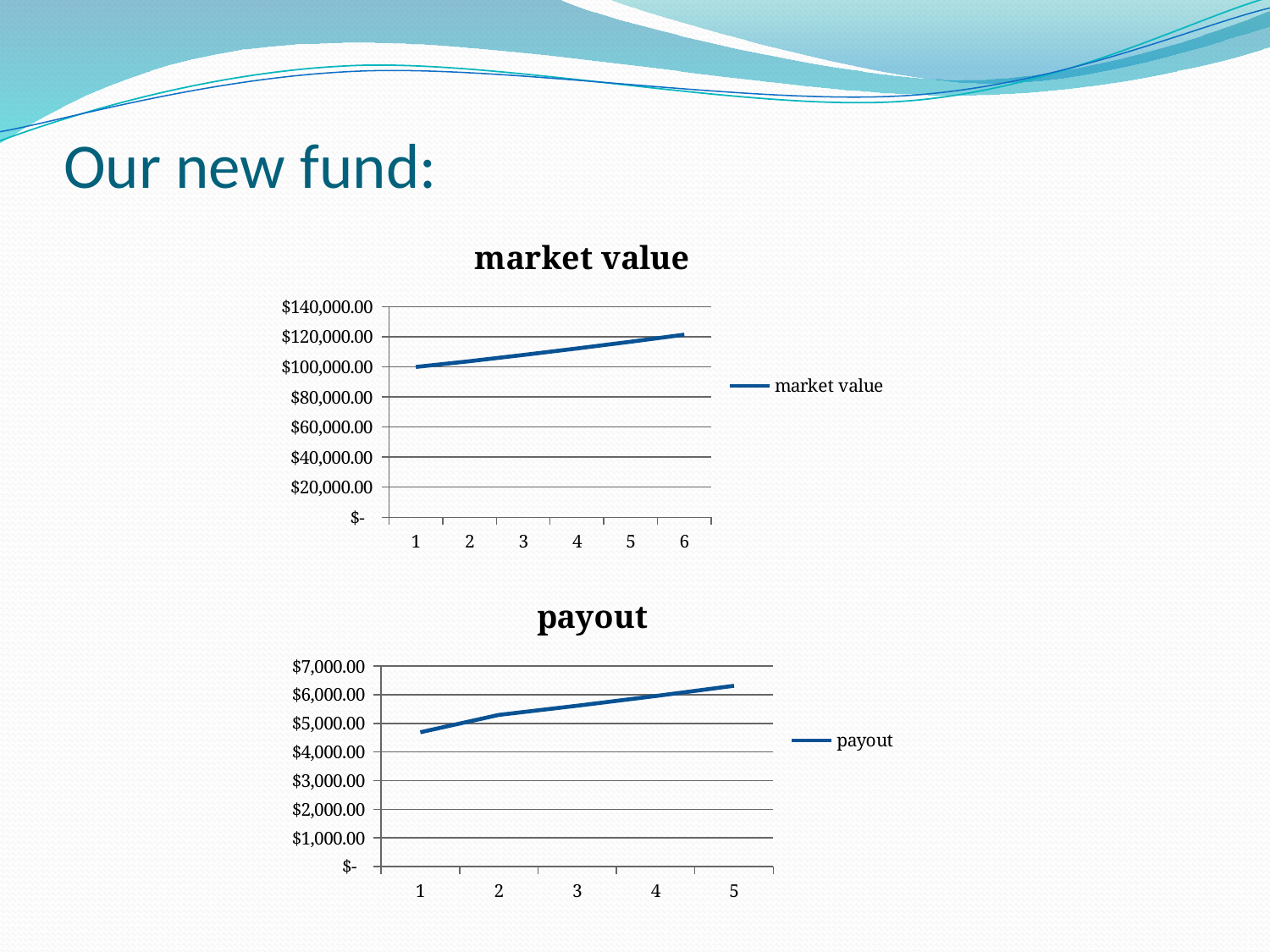
How many series does the legend of the "market value" chart list? 1 In the "market value" chart, how many points are plotted along the x axis? 6 What kind of chart is the "market value" chart? line chart In the "market value" chart, is the value at point 6 greater or less than $100,000.00? greater In the "payout" chart, is the value at point 1 greater or less than $5,000.00? less What kind of chart is the "payout" chart? line chart In the "payout" chart, which point has the highest value? 5 In the "payout" chart, do the values rise or fall from 1 to 5? rise In the "market value" chart, do the values rise or fall from 1 to 6? rise In the "market value" chart, which point has the lowest value? 1 In the "payout" chart, how many points are plotted along the x axis? 5 In the "payout" chart, is the value at point 5 greater or less than $6,000.00? greater